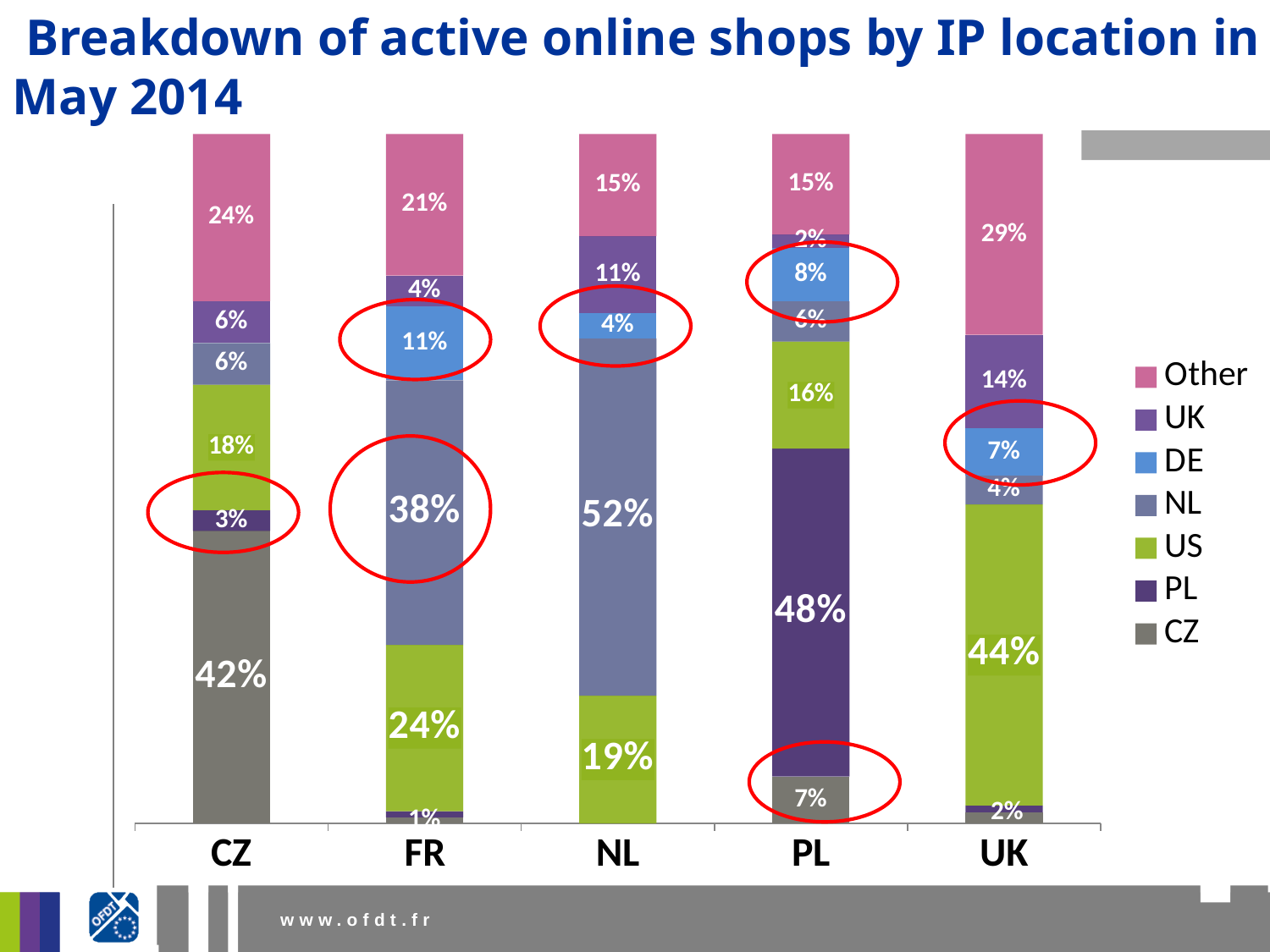
What is the difference between the DE share in the FR bar and the DE share in the NL bar? 7% What is the 'Other' share in the UK bar? 29% What is the US share in the UK bar? 44% What share of active online shops in the CZ bar are located in CZ? 42% What is the PL share in the PL bar? 48% Which country's bar has the largest 'Other' segment? UK Which is larger: the US share in the FR bar or the US share in the NL bar? FR What is the NL share in the FR bar? 38% How many series does the legend list? 7 What kind of chart is shown on the slide? Stacked bar chart What is the NL share in the NL bar? 52% How many countries are shown along the x axis? 5